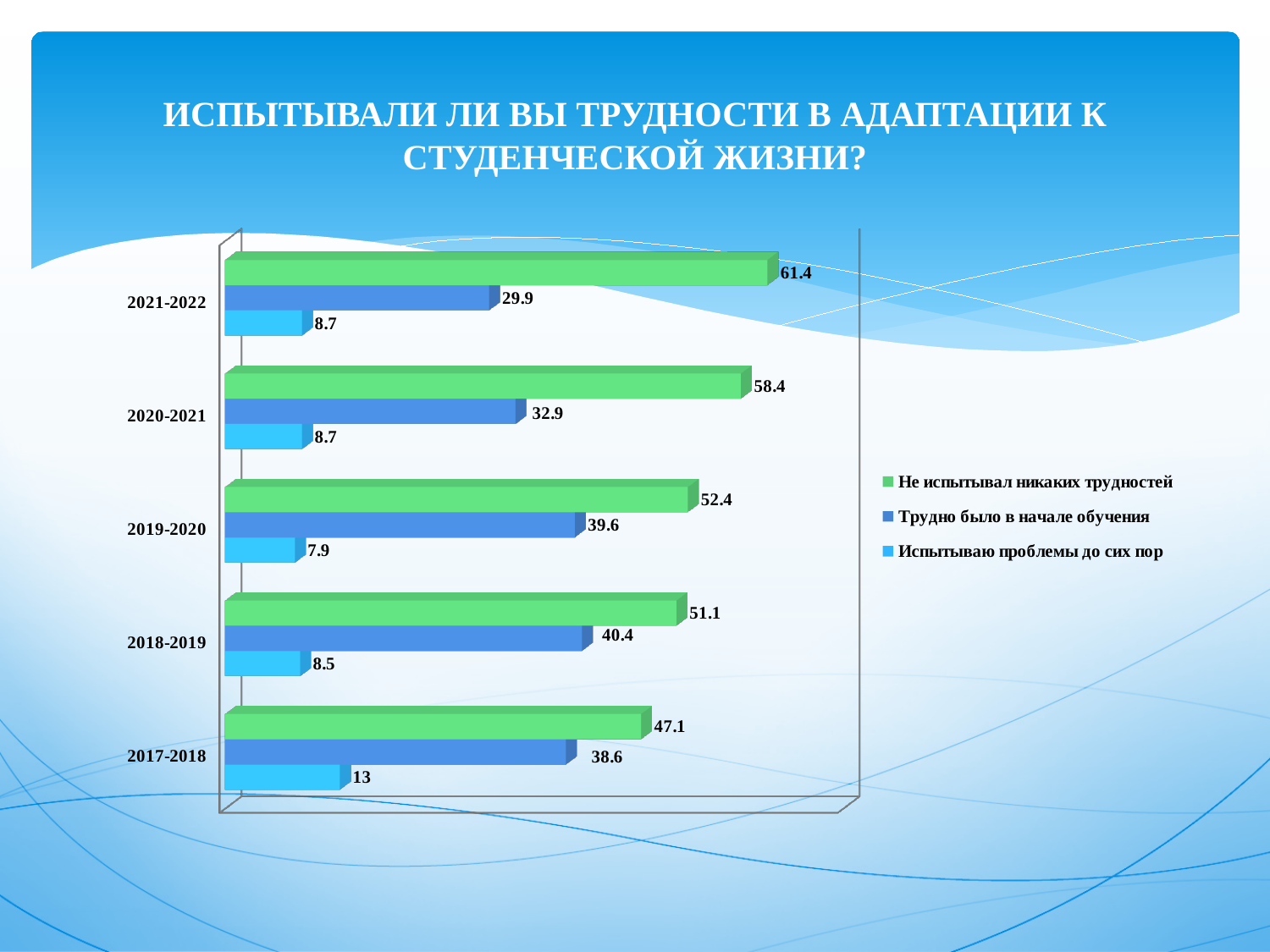
Which colour represents "Испытываю проблемы до сих пор" in the legend? Light blue What is the value for "Испытываю проблемы до сих пор" in 2017-2018? 13 What is the value for "Трудно было в начале обучения" in 2018-2019? 40.4 In which academic year is the value for "Не испытывал никаких трудностей" the highest? 2021-2022 What is the difference between the "Не испытывал никаких трудностей" values for 2021-2022 and 2017-2018? 14.3 How many academic years are shown on the chart? 5 In which academic year is the value for "Испытываю проблемы до сих пор" the lowest? 2019-2020 Does the value for "Не испытывал никаких трудностей" rise or fall from 2017-2018 to 2021-2022? Rise What is the value for "Не испытывал никаких трудностей" in 2021-2022? 61.4 How many series does the legend list? 3 What kind of chart is shown on the slide? Bar chart Which is larger: the "Трудно было в начале обучения" value for 2019-2020 or for 2020-2021? 2019-2020